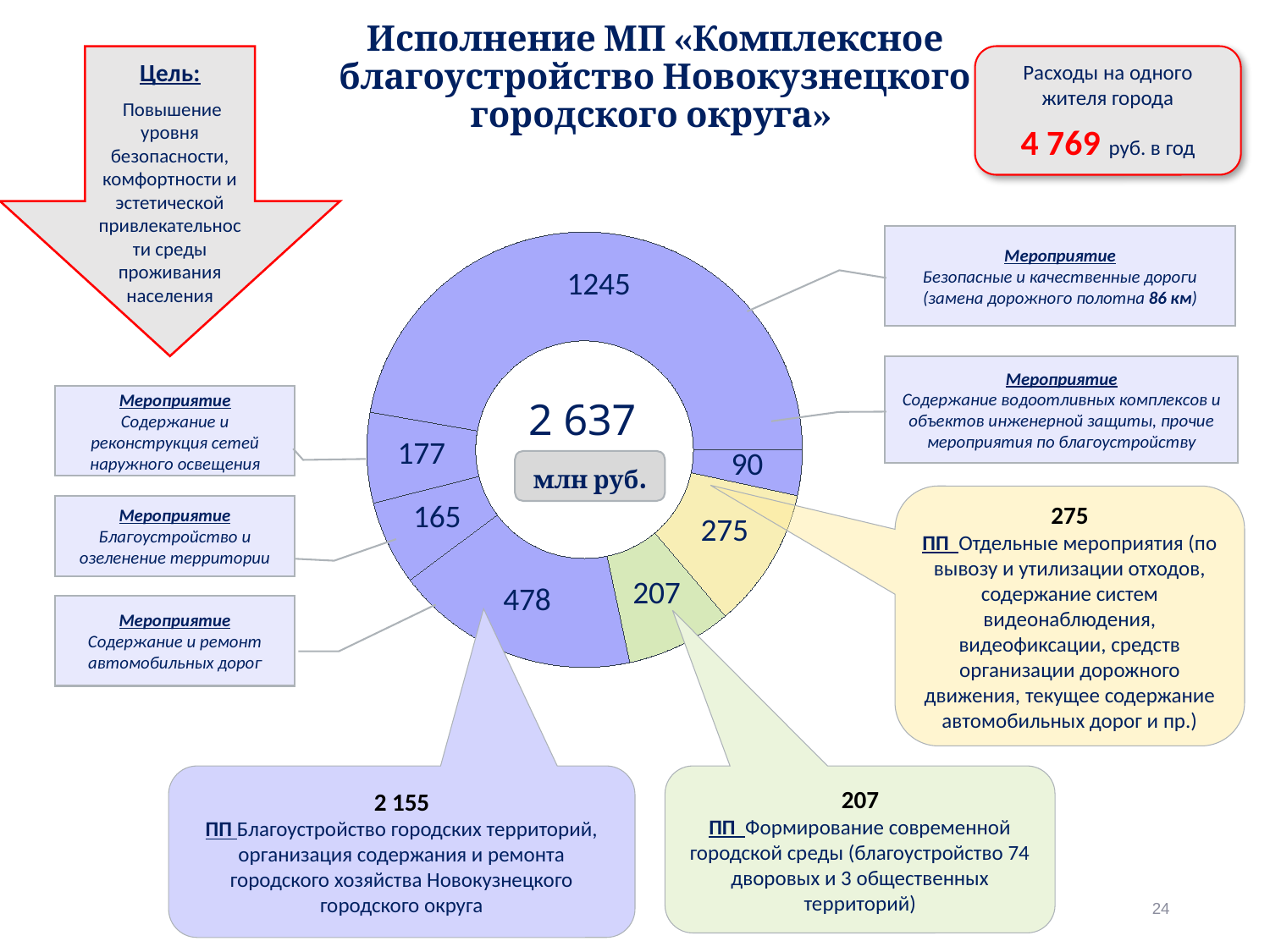
What is the value of the segment for «Содержание и реконструкция сетей наружного освещения»? 177 What is the total value shown in the centre of the donut chart? 2 637 млн руб. Which segment of the donut chart has the smallest value? 90 (Содержание водоотливных комплексов и объектов инженерной защиты) What is the value of «Расходы на одного жителя города» shown in the box at the top right? 4 769 руб. в год What is the value of the segment for «Благоустройство и озеленение территории»? 165 Which is larger: the segment for «Отдельные мероприятия» (275) or the segment for «Формирование современной городской среды» (207)? Отдельные мероприятия (275) What is the value of the segment for «Содержание и ремонт автомобильных дорог»? 478 What is the difference between the segment valued 1245 and the segment valued 478? 767 What is the value of the segment for «Безопасные и качественные дороги»? 1245 How many segments does the donut chart have? 7 Which segment of the donut chart has the largest value? 1245 (Безопасные и качественные дороги) What kind of chart is shown on the slide? Donut (pie) chart